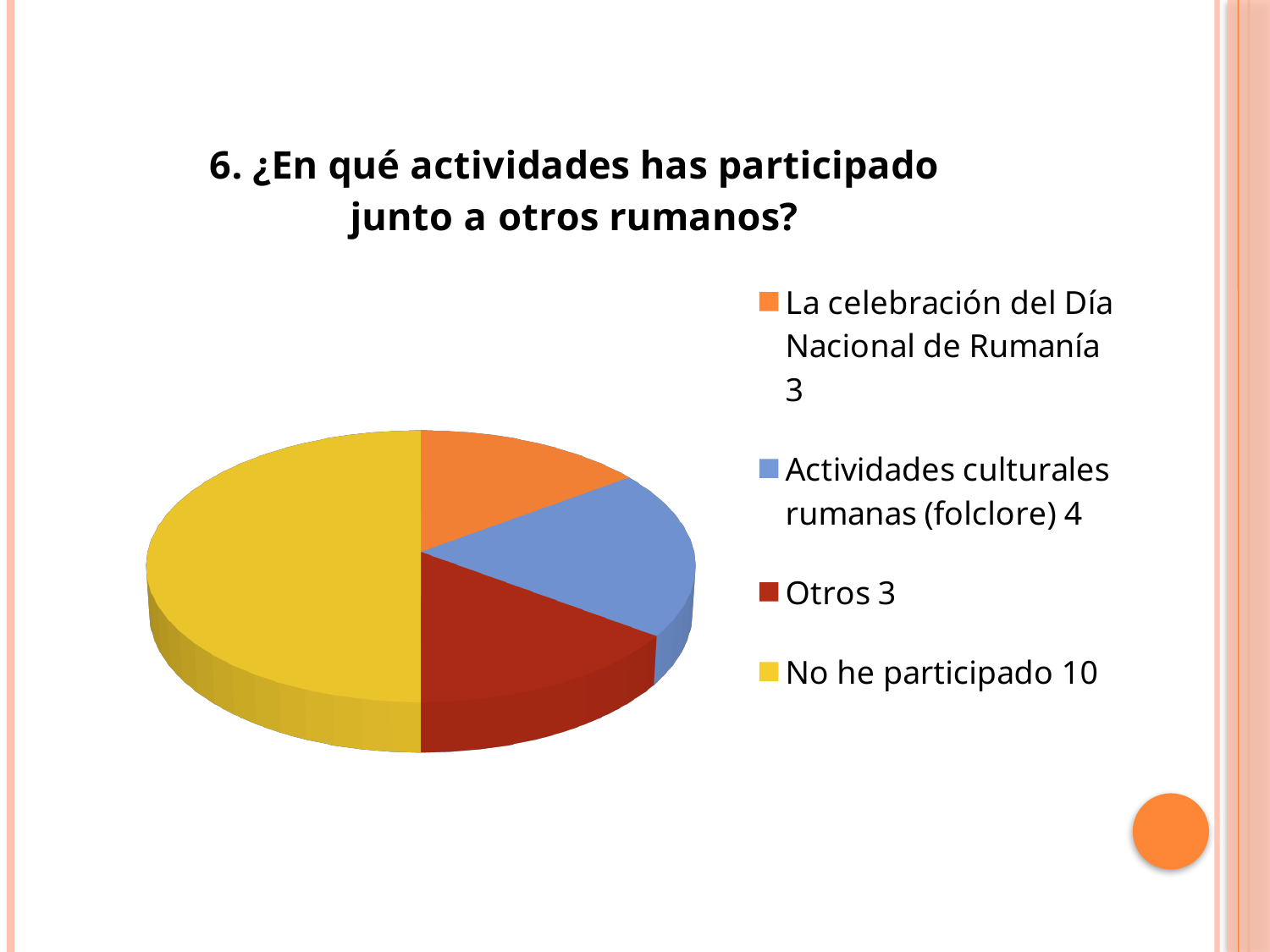
How many slices does the pie chart have? 4 What colour is the slice for "No he participado"? yellow Which is larger: "Actividades culturales rumanas (folclore)" or "Otros"? Actividades culturales rumanas (folclore) Which category has the largest slice of the pie? No he participado What is the value for "No he participado"? 10 What is the value for "La celebración del Día Nacional de Rumanía"? 3 What is the difference between the values for "No he participado" and "Otros"? 7 What is the difference between the values for "No he participado" and "Actividades culturales rumanas (folclore)"? 6 What is the value for "Actividades culturales rumanas (folclore)"? 4 What is the value for "Otros"? 3 What share of the pie does "No he participado" represent? 50% What kind of chart is shown on the slide? pie chart